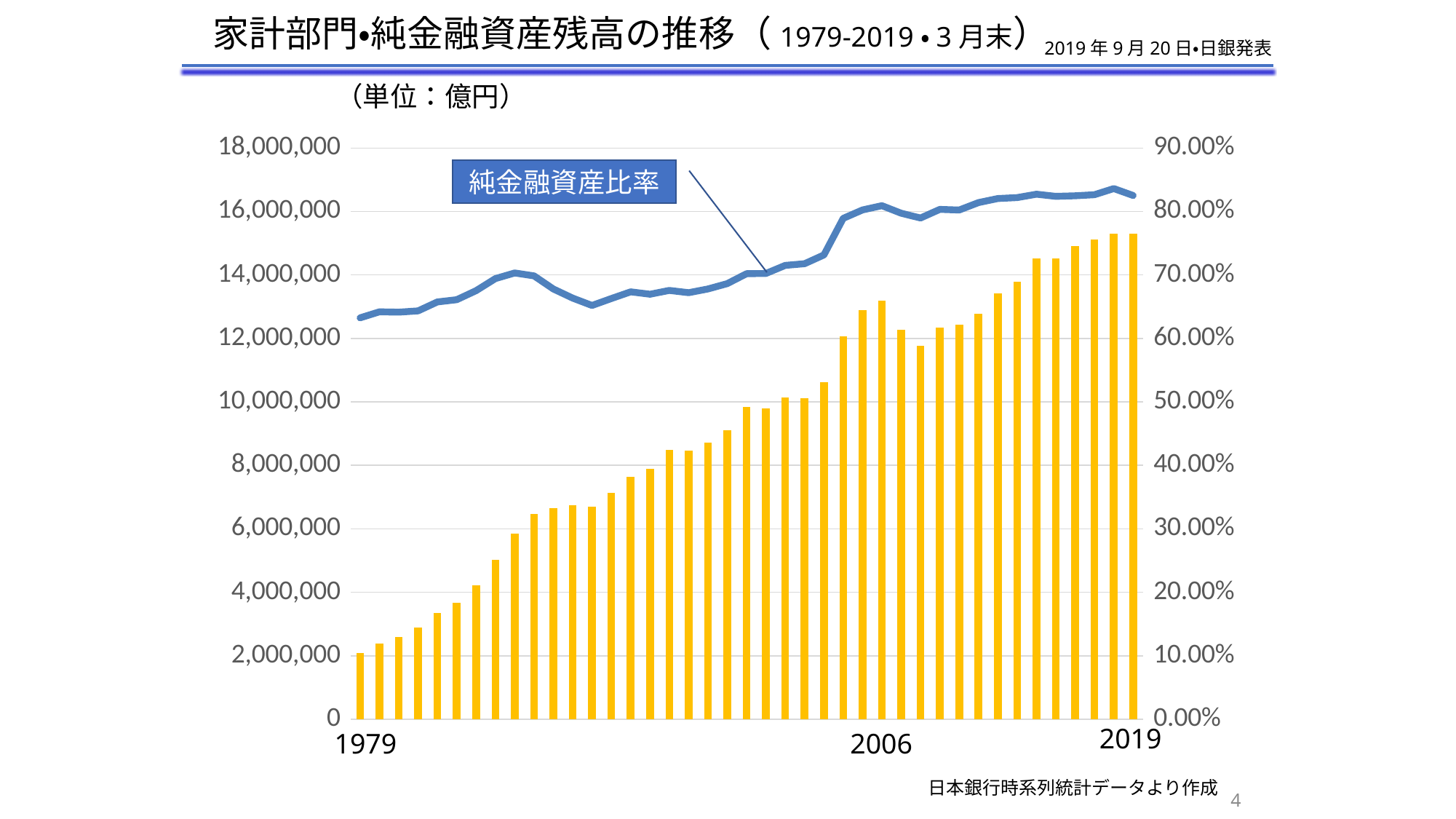
Is the bar value for 1979 greater or less than 4,000,000? less What is the label shown in the box pointing to the line series? 純金融資産比率 Is the bar value for 2006 greater or less than 10,000,000? greater How many bars (years) are plotted in the chart? 41 Which year has the lowest bar value? 1979 Which is larger, the bar value for 2006 or the bar value for 2019? 2019 What unit is stated for the bar values on the slide? 億円 Is the 純金融資産比率 line value for 1979 greater or less than 70.00%? less What kind of chart is shown on the slide? A bar chart combined with a line chart Do the bar values generally rise or fall from 1979 to 2019? rise